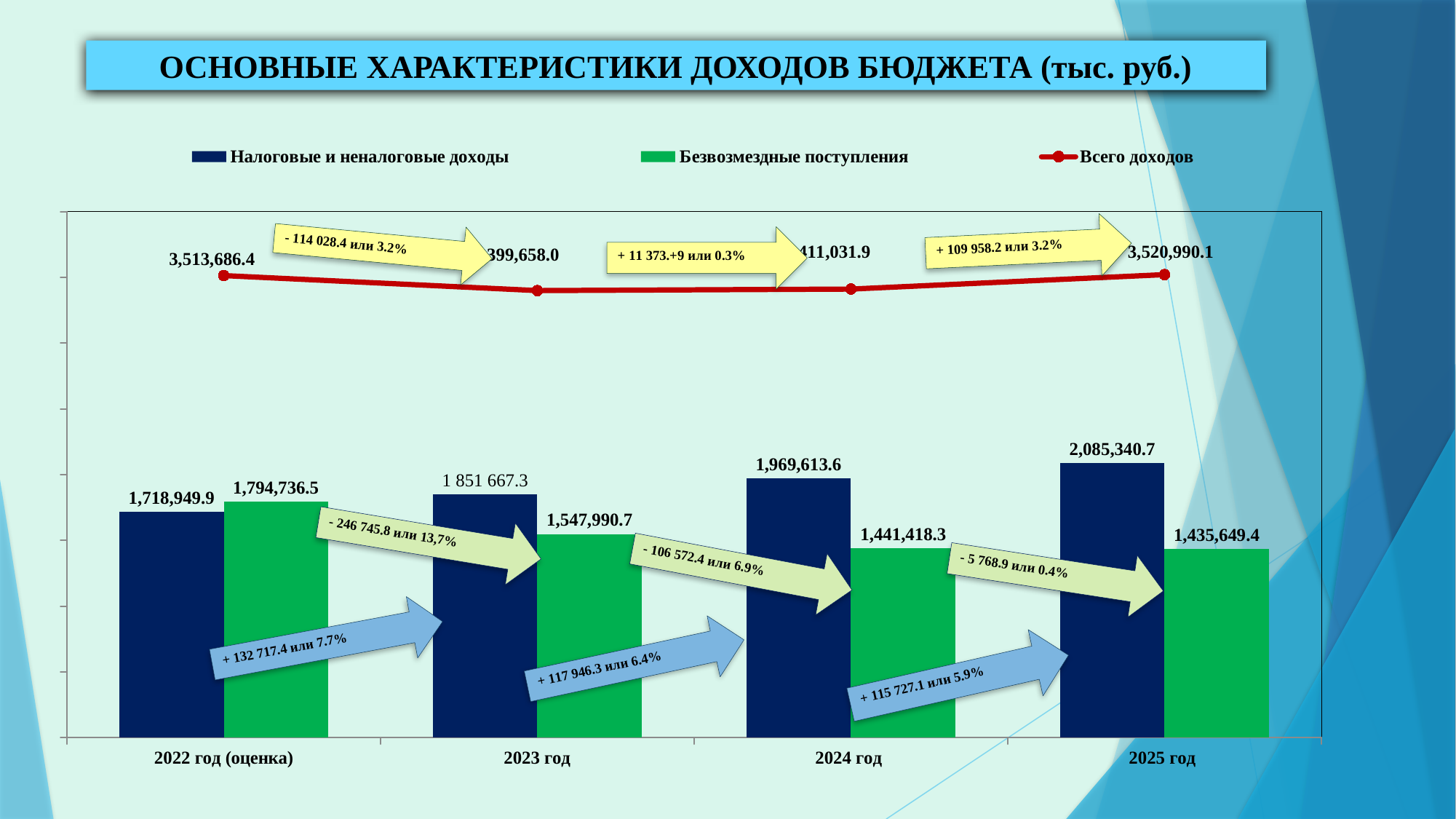
In which year is Налоговые и неналоговые доходы the highest? 2025 год What is the difference between Налоговые и неналоговые доходы and Безвозмездные поступления in 2025 год? 649,691.3 What is the value of Безвозмездные поступления for 2022 год (оценка)? 1,794,736.5 How many series does the legend list? 3 What is the value of Налоговые и неналоговые доходы for 2025 год? 2,085,340.7 How many years are shown on the x axis of the chart? 4 What is the value of Всего доходов for 2025 год? 3,520,990.1 Do the values of Налоговые и неналоговые доходы rise or fall from 2022 to 2025? rise In which year is Безвозмездные поступления the lowest? 2025 год What is the value of Всего доходов for 2022 год (оценка)? 3,513,686.4 In 2022 год (оценка), which is larger: Налоговые и неналоговые доходы or Безвозмездные поступления? Безвозмездные поступления What is the value of Налоговые и неналоговые доходы for 2024 год? 1,969,613.6